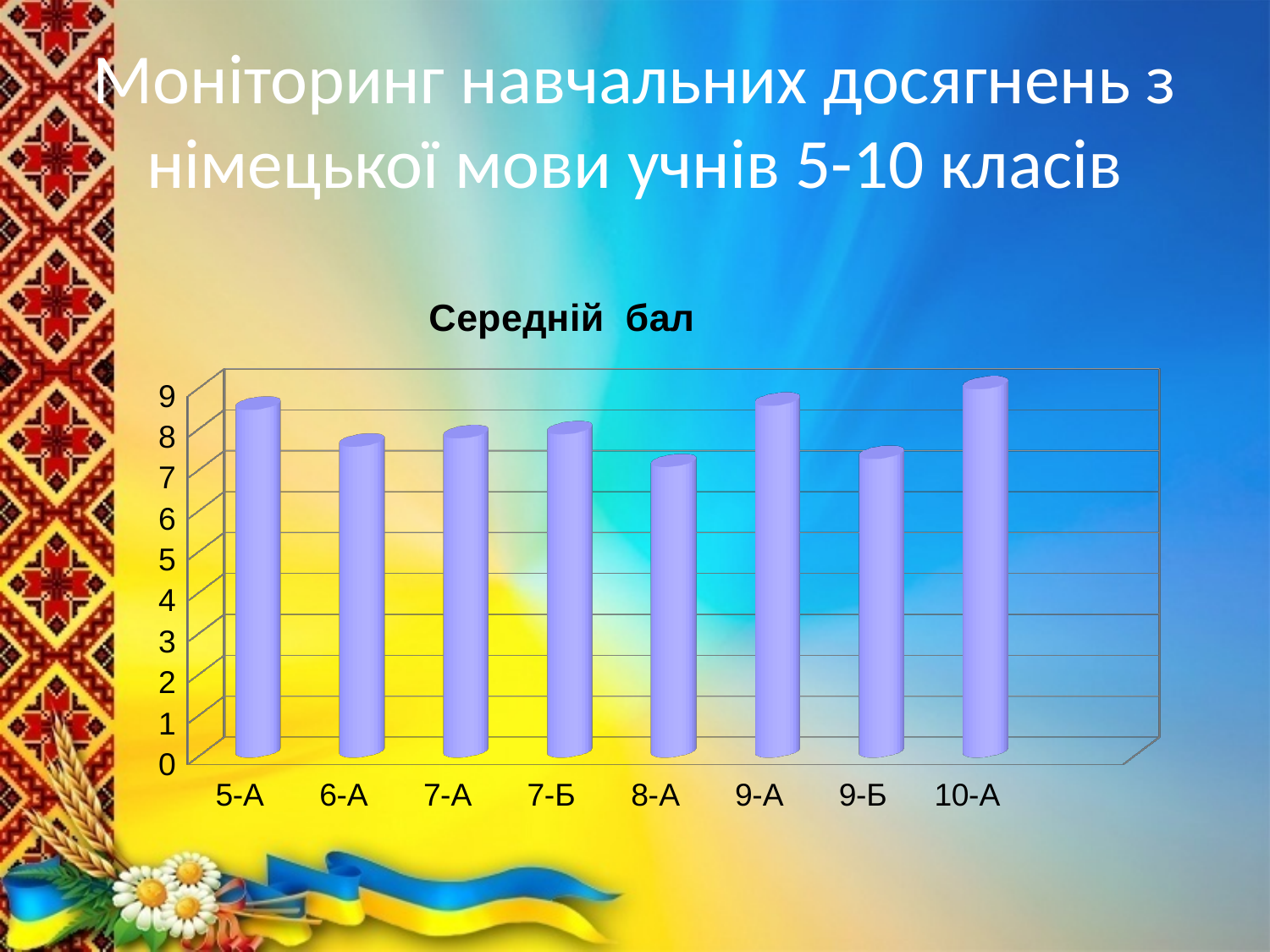
Which class has the highest average score in the chart? 10-А What is the title of the chart? Середній бал Which has the larger value, 9-А or 9-Б? 9-А Is the value for 9-А greater or less than 8? greater Which has the larger value, 10-А or 6-А? 10-А What kind of chart is shown on the slide? bar chart Is the value for 5-А greater or less than 8? greater How many classes (categories) are shown on the x axis of the chart? 8 Is the value for 9-Б greater or less than 8? less Which has the larger value, 5-А or 8-А? 5-А